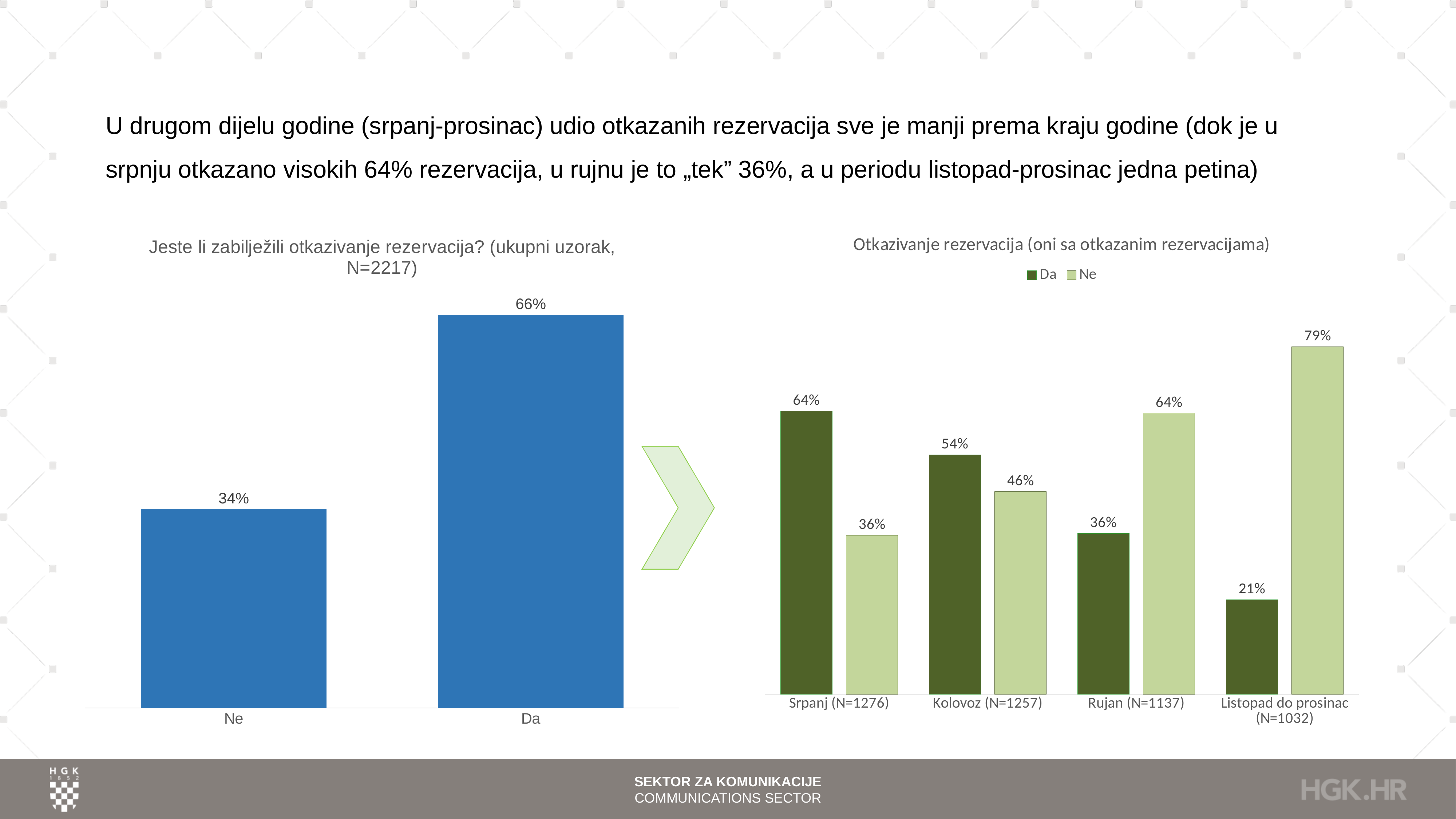
In the right chart (Otkazivanje rezervacija), do the Da values rise or fall from Srpanj to Listopad do prosinac? fall In the right chart (Otkazivanje rezervacija), which category has the lowest Da value? Listopad do prosinac (N=1032) In the left chart (Jeste li zabilježili otkazivanje rezervacija?), what is the difference between Da and Ne? 32% In the right chart (Otkazivanje rezervacija), which category has the highest Ne value? Listopad do prosinac (N=1032) In the right chart (Otkazivanje rezervacija), what is the difference between the Da and Ne values for Rujan (N=1137)? 28% In the left chart (Jeste li zabilježili otkazivanje rezervacija?), how many categories are shown? 2 In the left chart (Jeste li zabilježili otkazivanje rezervacija?), what is the value for Ne? 34% In the right chart (Otkazivanje rezervacija), what is the Ne value for Listopad do prosinac (N=1032)? 79% In the right chart (Otkazivanje rezervacija), how many series does the legend list? 2 In the right chart (Otkazivanje rezervacija), what is the Da value for Kolovoz (N=1257)? 54% In the left chart (Jeste li zabilježili otkazivanje rezervacija?), what is the value for Da? 66% In the right chart (Otkazivanje rezervacija), what is the Da value for Srpanj (N=1276)? 64%